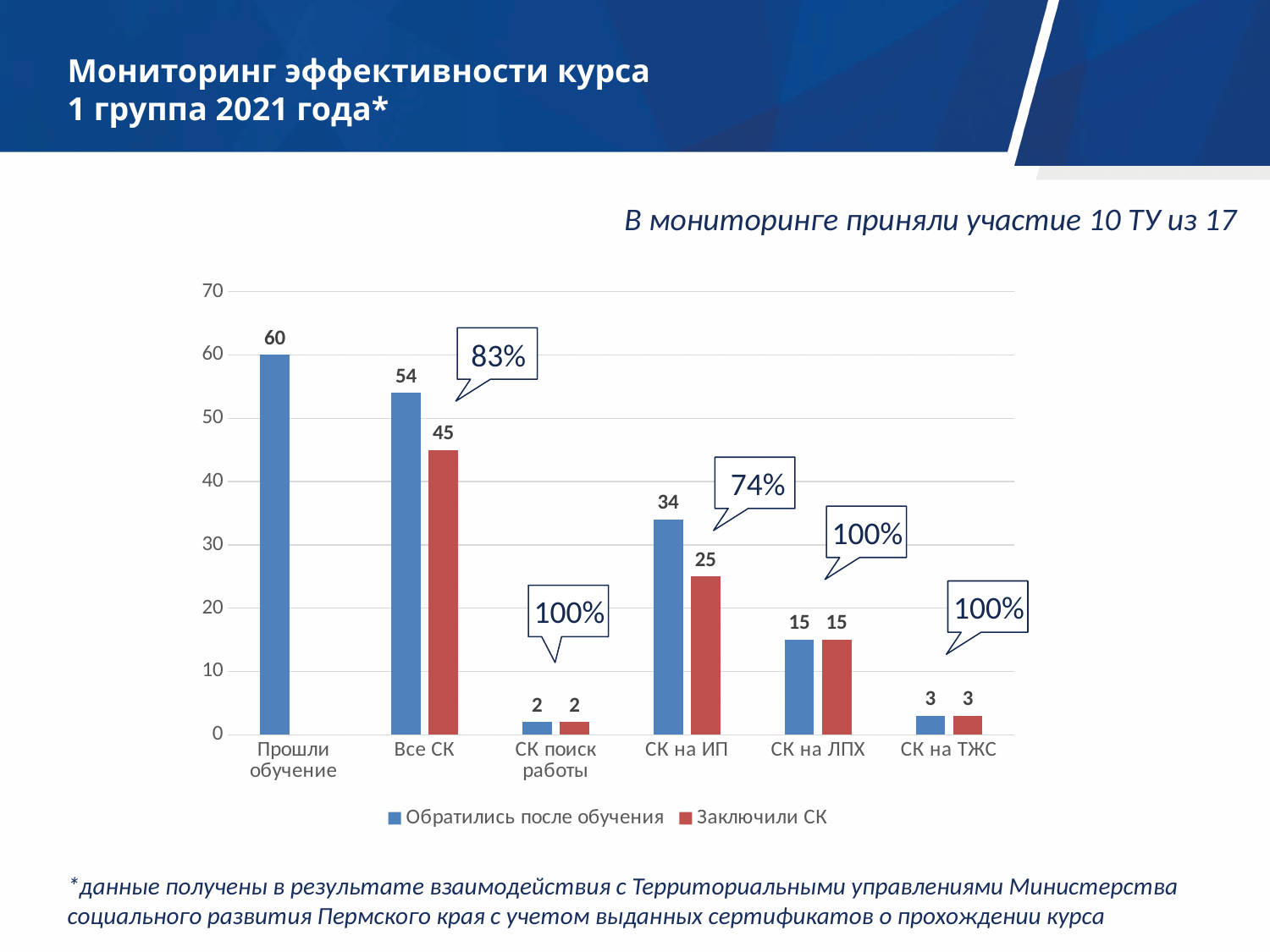
What is the value of "Обратились после обучения" for "Все СК"? 54 What colour are the "Заключили СК" bars? red How many categories are shown on the x axis? 6 How many series does the legend list? 2 What kind of chart is shown on the slide? bar chart Which category has the highest value for "Обратились после обучения"? Прошли обучение Which is larger for "СК на ИП": "Обратились после обучения" or "Заключили СК"? Обратились после обучения What is the difference between "Обратились после обучения" and "Заключили СК" for "Все СК"? 9 What percentage is shown in the callout above the "Все СК" bars? 83% What is the value of "Обратились после обучения" for "Прошли обучение"? 60 What is the value of "Заключили СК" for "СК на ИП"? 25 Which category has the lowest value for "Заключили СК"? СК поиск работы